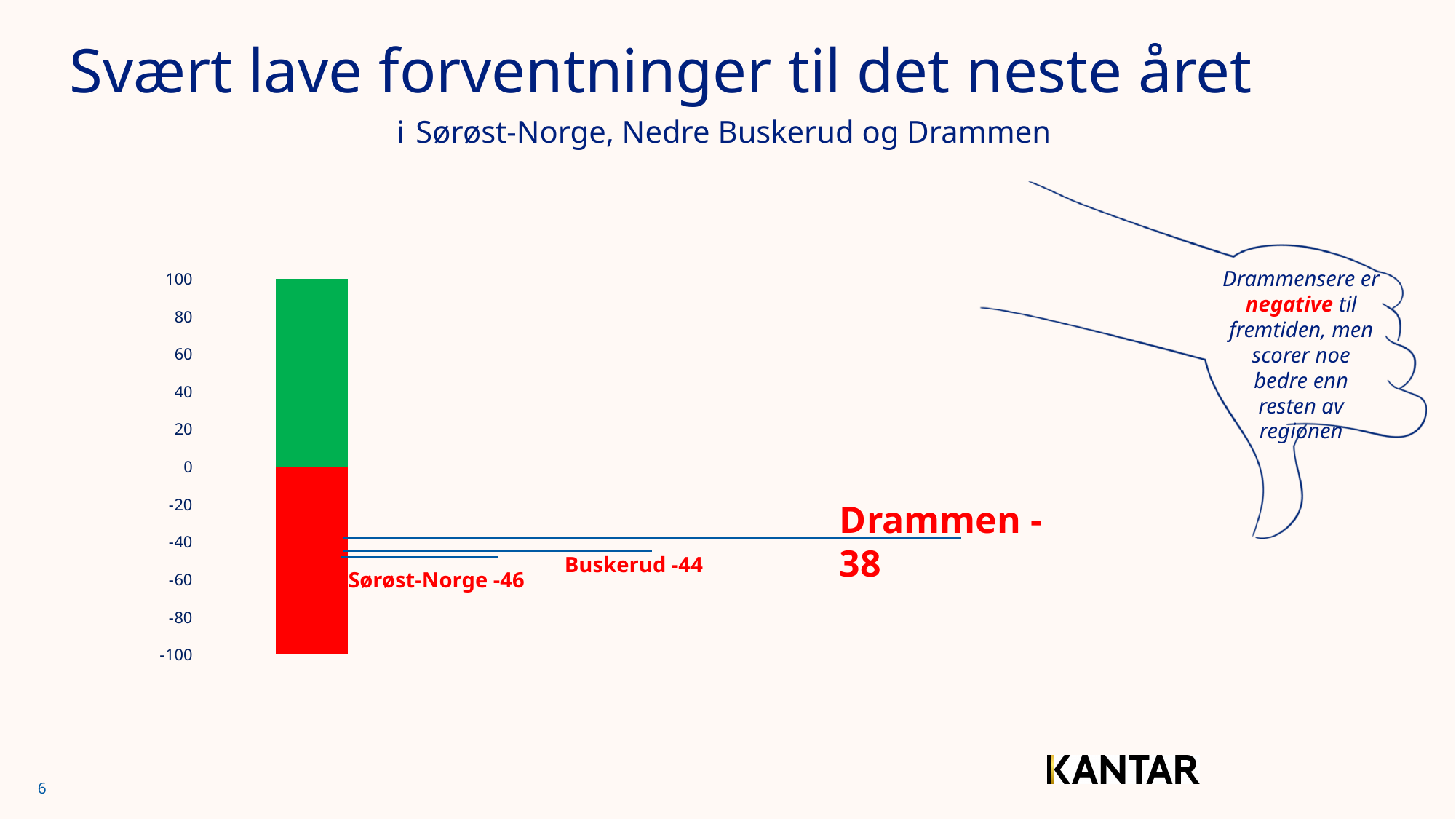
What is the value shown for Sørøst-Norge? -46 What is the difference between the values for Drammen and Sørøst-Norge? 8 Which of the three labelled regions has the lowest value? Sørøst-Norge How many regions are labelled with values on the chart? 3 What is the value shown for Buskerud? -44 What is the value shown for Drammen? -38 Is the value for Drammen greater or less than -40? greater Which of the three labelled regions has the highest value? Drammen What is the difference between the values for Buskerud and Sørøst-Norge? 2 What is the maximum value shown on the vertical axis? 100 What colour is the part of the bar below 0? Red Which is larger, the value for Drammen or the value for Buskerud? Drammen